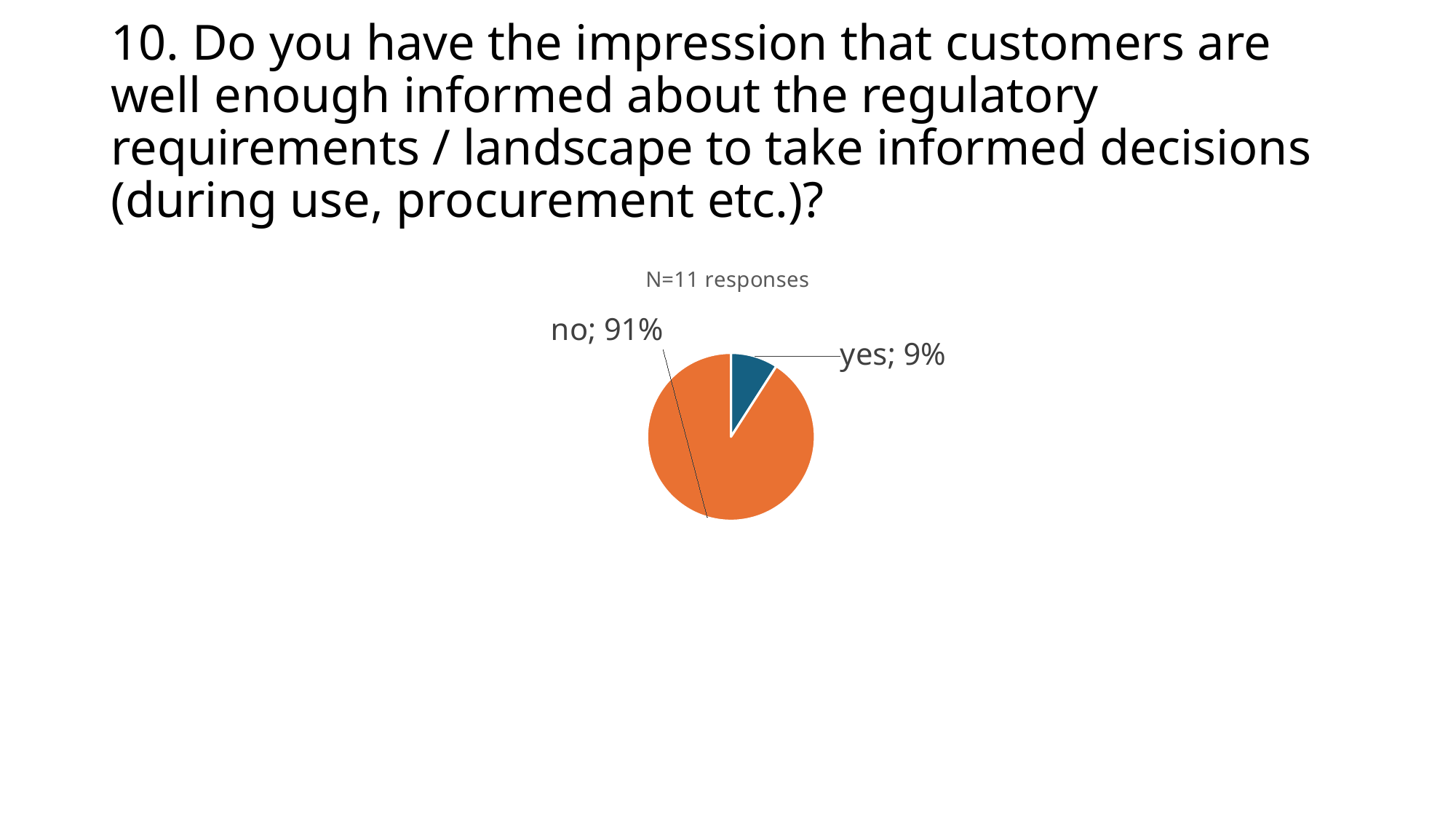
Which response has the smallest share of the pie? yes Which response has the largest share of the pie? no What share of responses is "no"? 91% What colour is the "yes" slice of the pie? blue What share of responses is "yes"? 9% How many slices does the pie chart have? 2 Which is larger, the share for "no" or the share for "yes"? no What is the difference in percentage points between the "no" and "yes" shares? 82 What kind of chart is shown on the slide? pie chart How many responses does the chart say it is based on? 11